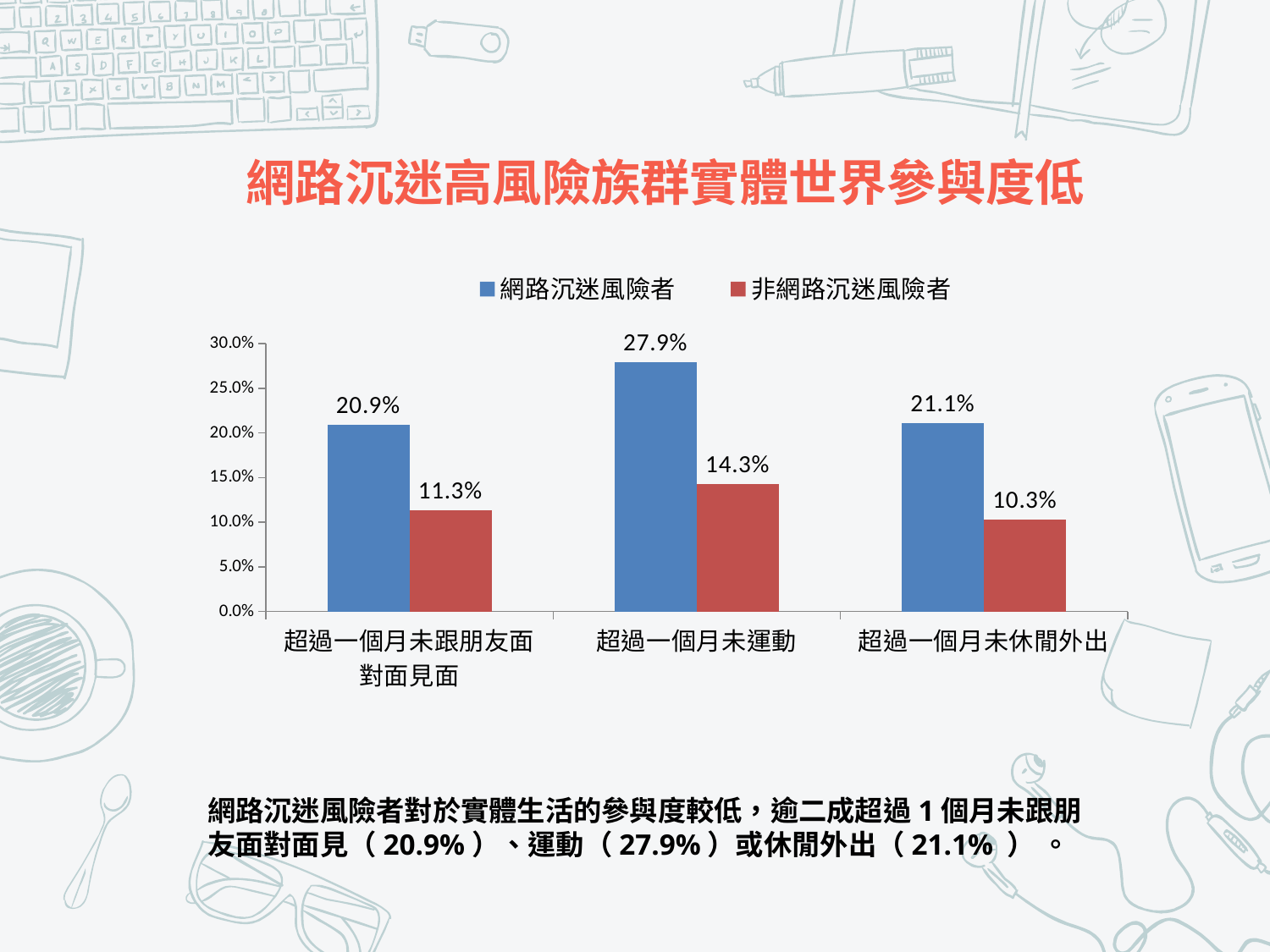
What is the value for 非網路沉迷風險者 in the 超過一個月未休閒外出 category? 10.3% What is the difference between 網路沉迷風險者 and 非網路沉迷風險者 in the 超過一個月未運動 category? 13.6% How many series does the legend list? 2 What kind of chart is shown on the slide? bar chart Which colour represents 非網路沉迷風險者 in the chart? red What is the value for 網路沉迷風險者 in the 超過一個月未運動 category? 27.9% What is the value for 網路沉迷風險者 in the 超過一個月未跟朋友面對面見面 category? 20.9% Which category has the highest value for 網路沉迷風險者? 超過一個月未運動 Which is larger in the 超過一個月未跟朋友面對面見面 category: 網路沉迷風險者 or 非網路沉迷風險者? 網路沉迷風險者 Which category has the lowest value for 非網路沉迷風險者? 超過一個月未休閒外出 Is the value for 非網路沉迷風險者 in the 超過一個月未運動 category greater or less than 15.0%? less How many categories are shown on the x axis? 3